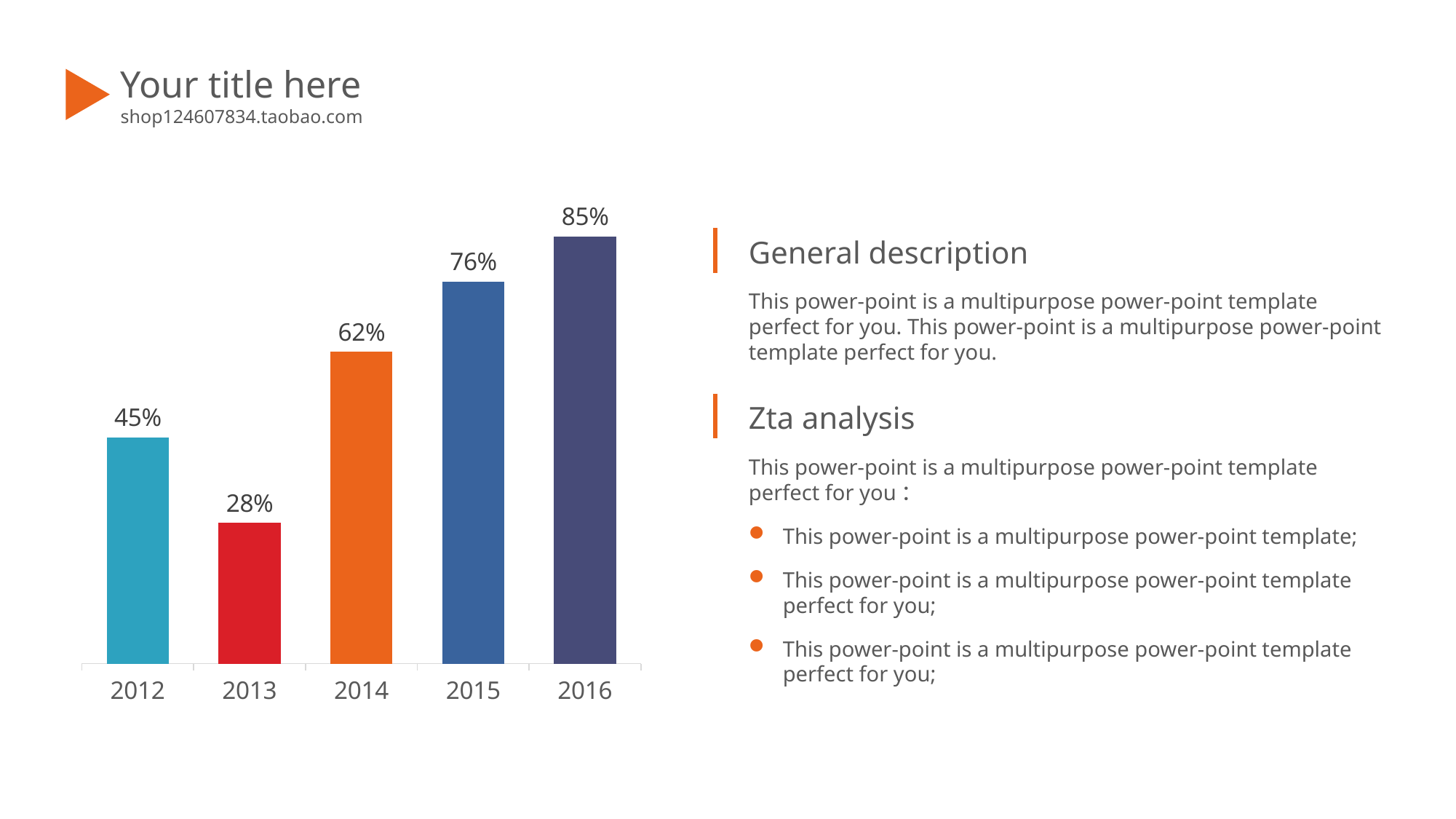
What is the value for 2014? 62% What is the value for 2016? 85% How many years are shown on the chart? 5 What is the difference between the values for 2016 and 2015? 9% What colour is the bar for 2014? orange What kind of chart is shown on the slide? bar chart Which is larger, the value for 2012 or the value for 2013? 2012 Which year has the lowest value? 2013 What is the value for 2012? 45% What is the difference between the values for 2014 and 2013? 34% What is the value for 2013? 28% Which year has the highest value? 2016